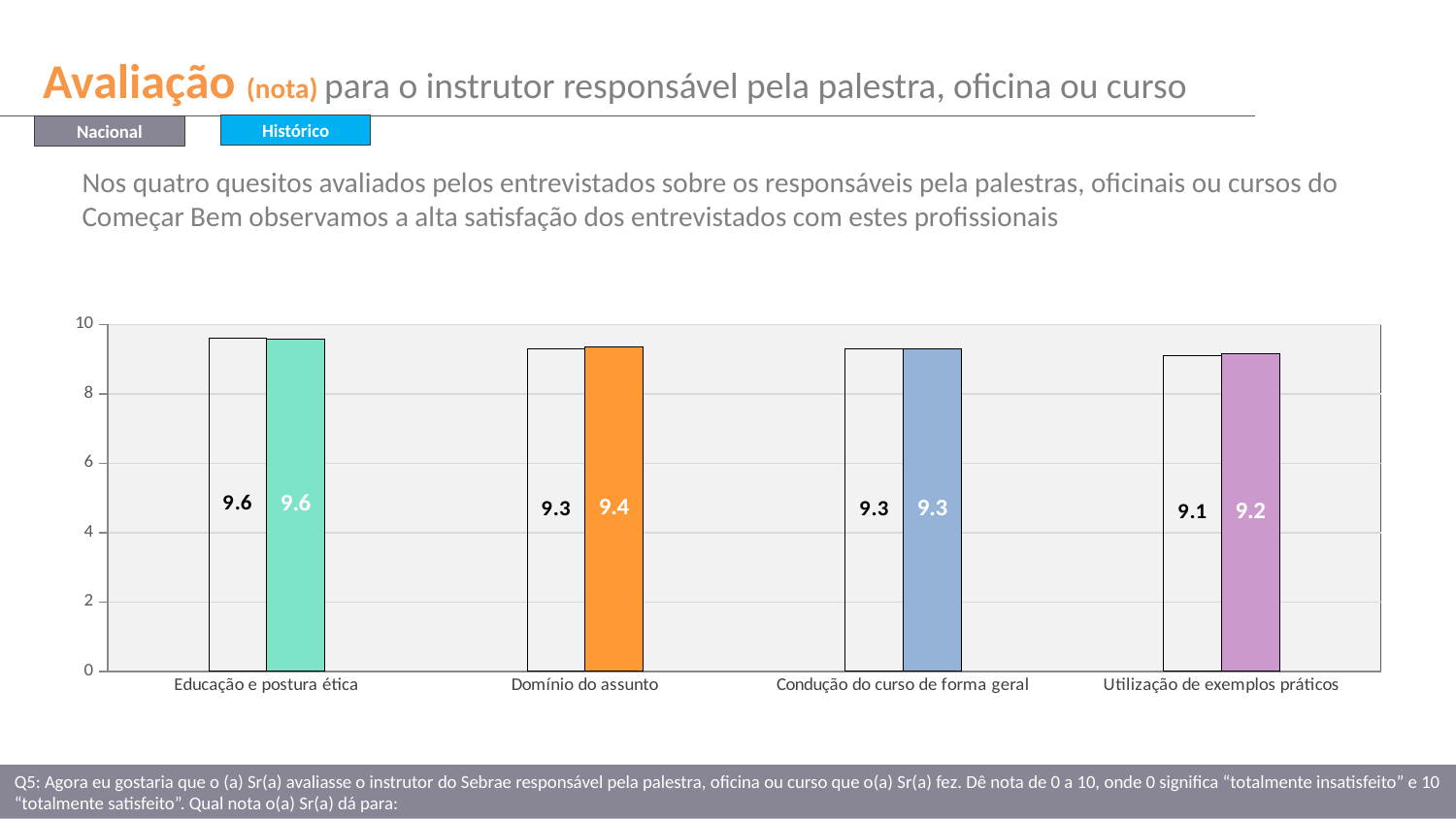
What is the value shown on the coloured (second) bar for Condução do curso de forma geral? 9.3 What is the value shown on the coloured (second) bar for Domínio do assunto? 9.4 What is the value shown on the white (first) bar for Educação e postura ética? 9.6 Which category has the lowest values in the chart? Utilização de exemplos práticos Is the value for Utilização de exemplos práticos greater or less than 8? greater What is the value shown on the white (first) bar for Utilização de exemplos práticos? 9.1 Which is larger: the coloured bar for Domínio do assunto or the coloured bar for Utilização de exemplos práticos? Domínio do assunto How many categories are shown on the x axis of the chart? 4 Which category has the highest values in the chart? Educação e postura ética What kind of chart is shown on the slide? bar chart What is the difference between the white bar for Educação e postura ética and the white bar for Utilização de exemplos práticos? 0.5 What is the maximum value shown on the y axis of the chart? 10